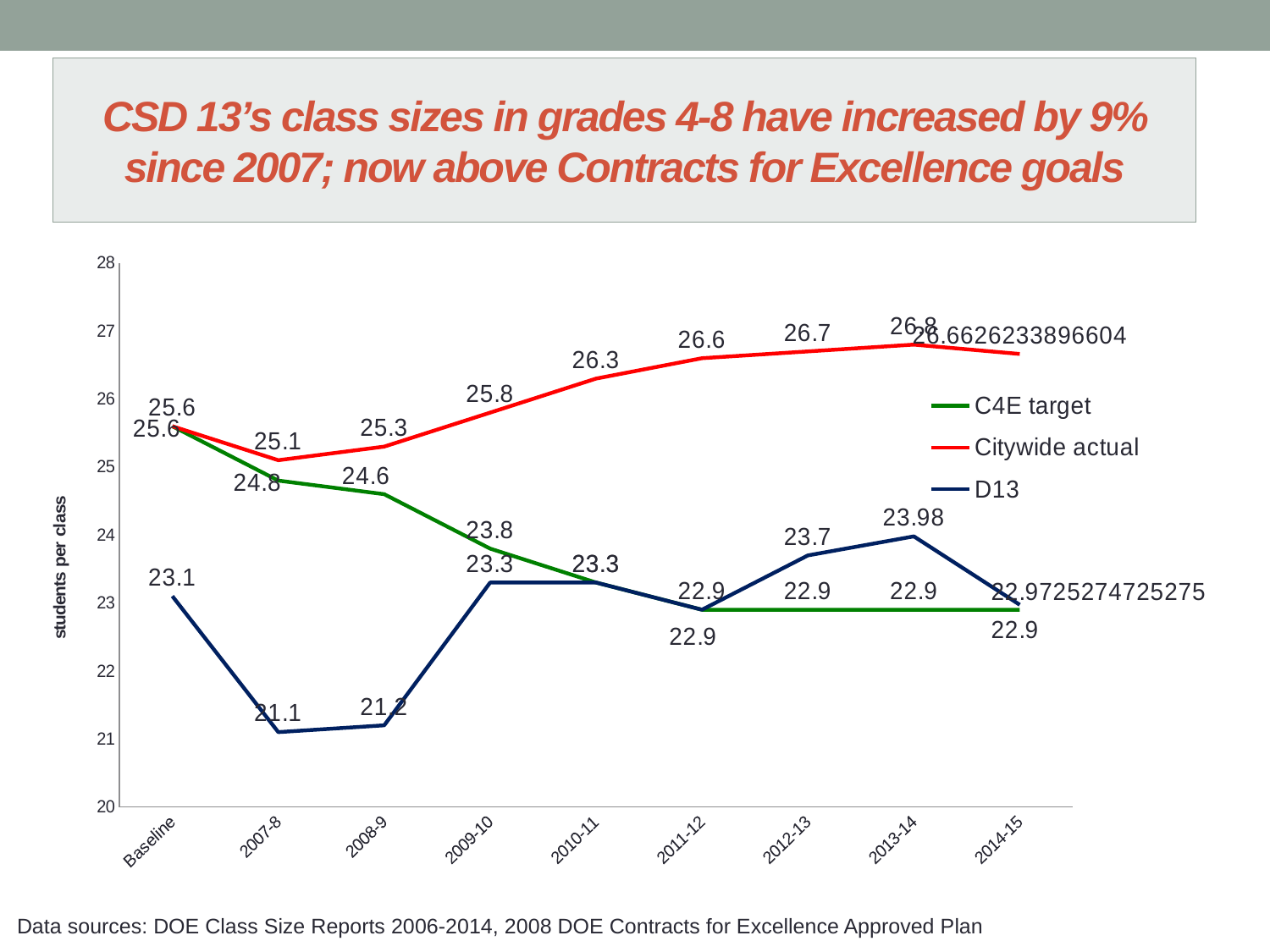
What is the C4E target value for 2008-9? 24.6 How many points are plotted along the x axis for each series? 9 What is the difference between the Citywide actual and D13 values in 2013-14? 2.82 What is the D13 value for 2013-14? 23.98 Does the Citywide actual series rise or fall from 2008-9 to 2013-14? rise In which year does the Citywide actual series reach its highest value? 2013-14 In which year is the D13 value lowest? 2007-8 How many series does the legend list? 3 Which is larger in 2013-14, the D13 value or the C4E target value? D13 What kind of chart is shown on the slide? line chart What is the Citywide actual value for 2010-11? 26.3 What is the label on the y axis? students per class